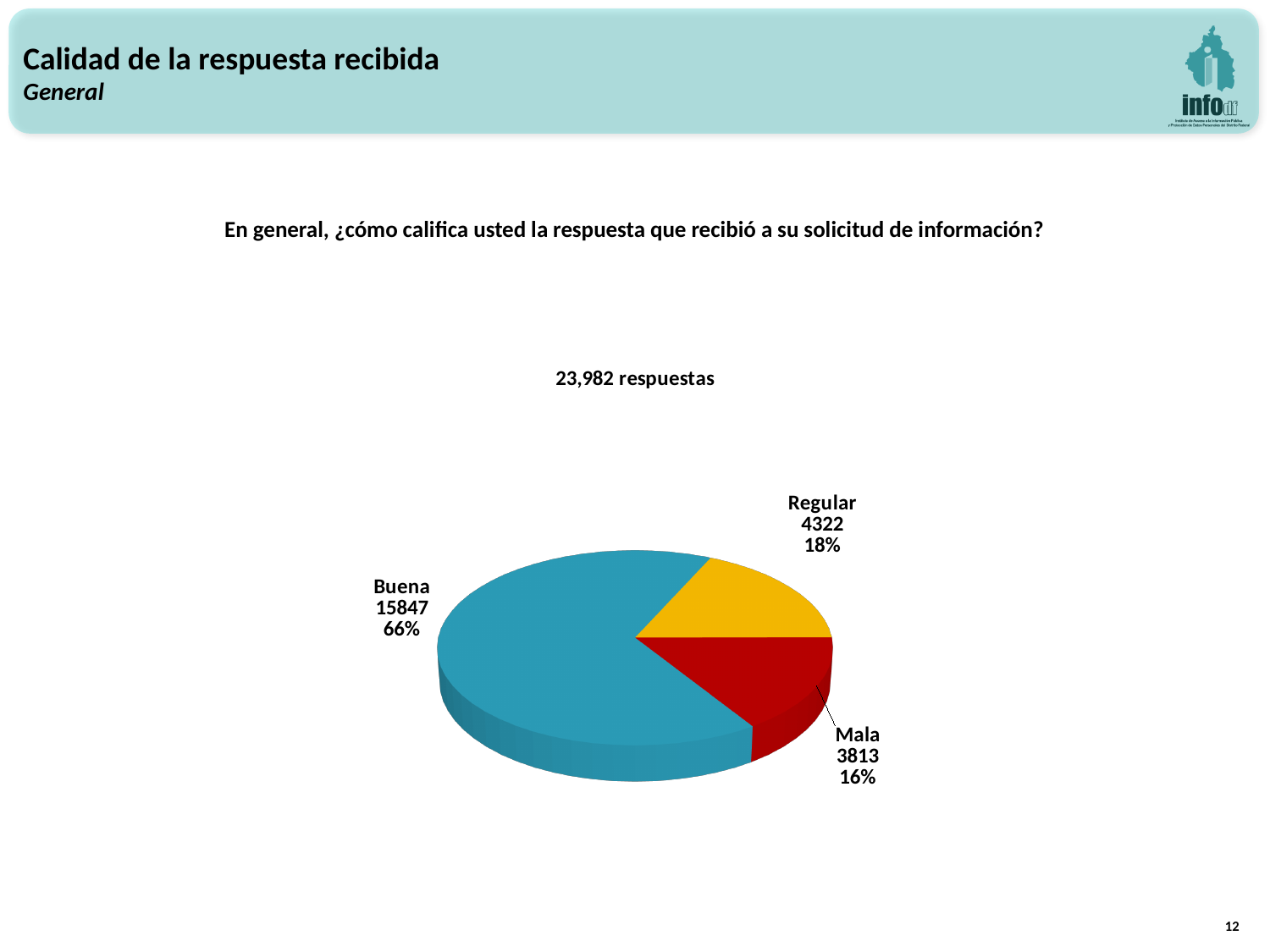
What share of the pie does the Buena slice represent? 66% What is the difference between the number of Regular and Mala responses? 509 What colour is the Regular slice? yellow Which category has the smallest slice? Mala How many responses were rated Buena? 15847 How many responses were rated Mala? 3813 How many categories does the pie chart have? 3 What share of the pie does the Mala slice represent? 16% Which category has the largest slice? Buena How many responses were rated Regular? 4322 What kind of chart is shown on the slide? pie chart How many responses does the chart report in total? 23,982 respuestas